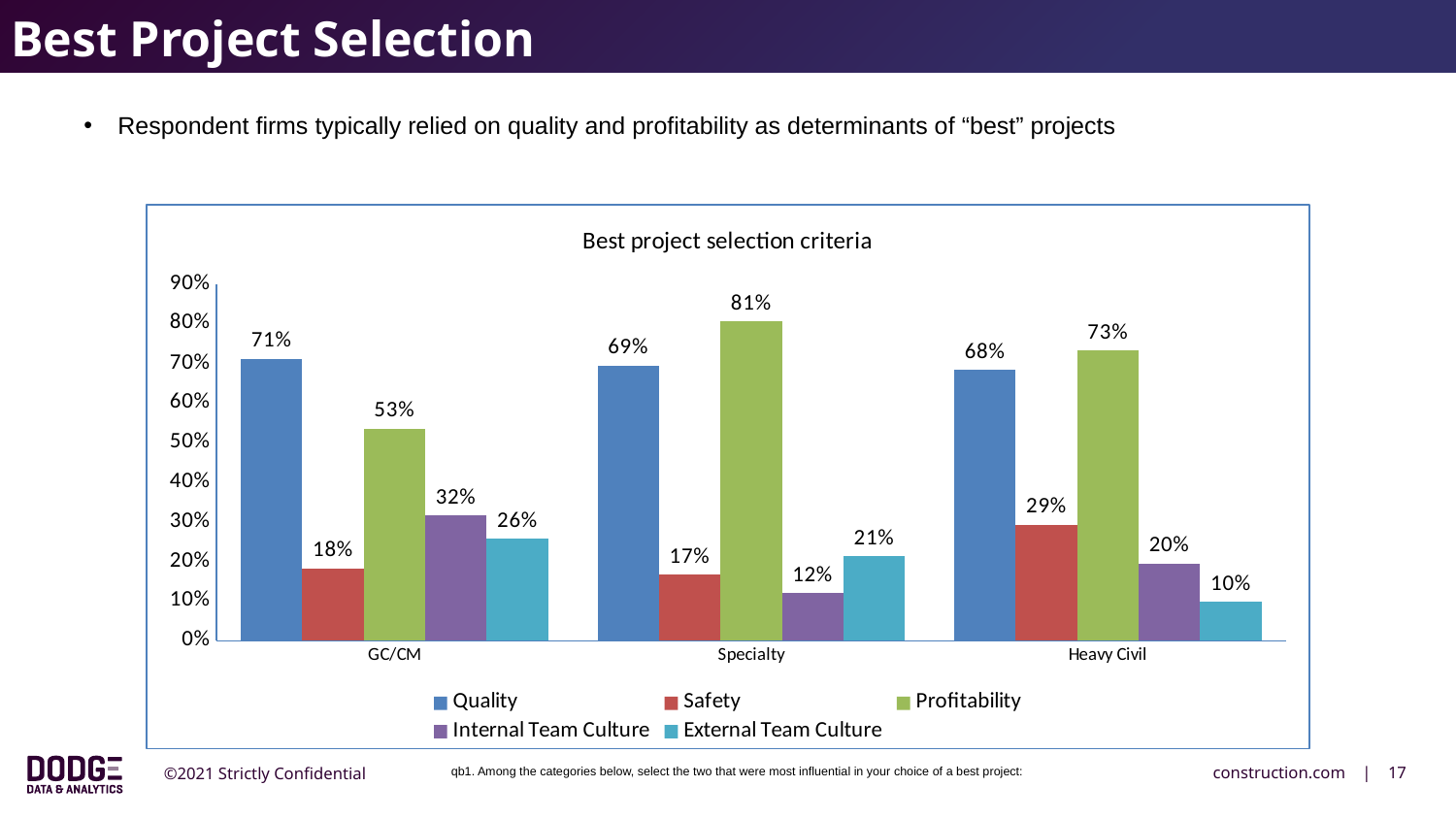
Which series has the lowest value in the GC/CM category? Safety How many series does the legend list? 5 What is the value for Quality in the GC/CM category? 71% How many categories are shown on the x axis? 3 What kind of chart is shown on the slide? Bar chart What is the difference between Profitability and Quality in the Heavy Civil category? 5% Which series has the highest value in the Specialty category? Profitability What is the value for Profitability in the Specialty category? 81% Which is larger: Safety in Heavy Civil or Safety in GC/CM? Safety in Heavy Civil What is the value for External Team Culture in the Heavy Civil category? 10% What is the title of the chart? Best project selection criteria Does the Internal Team Culture value rise or fall from GC/CM to Specialty? Fall